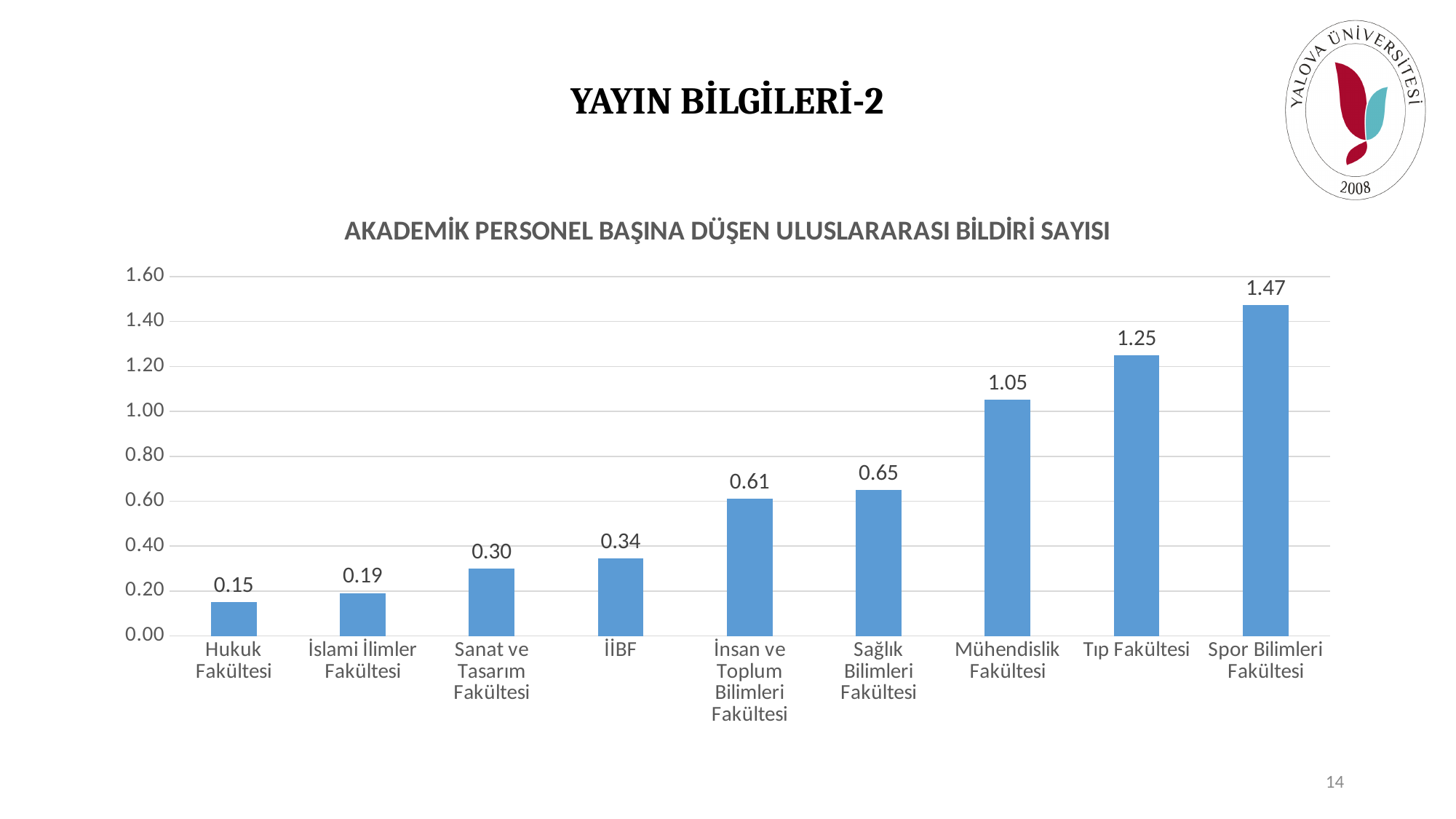
What is the difference between the values for Spor Bilimleri Fakültesi and Tıp Fakültesi? 0.22 What is the title of the chart? AKADEMİK PERSONEL BAŞINA DÜŞEN ULUSLARARASI BİLDİRİ SAYISI What kind of chart is shown on the slide? Bar chart What is the value for Sanat ve Tasarım Fakültesi? 0.30 Which faculty has the lowest value? Hukuk Fakültesi Which faculty has the highest value? Spor Bilimleri Fakültesi Is the value for Mühendislik Fakültesi greater or less than 1.00? greater What is the difference between the values for Sağlık Bilimleri Fakültesi and İnsan ve Toplum Bilimleri Fakültesi? 0.04 What is the value for İİBF? 0.34 How many faculties are shown on the chart? 9 Which is larger, the value for Mühendislik Fakültesi or the value for Sağlık Bilimleri Fakültesi? Mühendislik Fakültesi What is the value for Tıp Fakültesi? 1.25